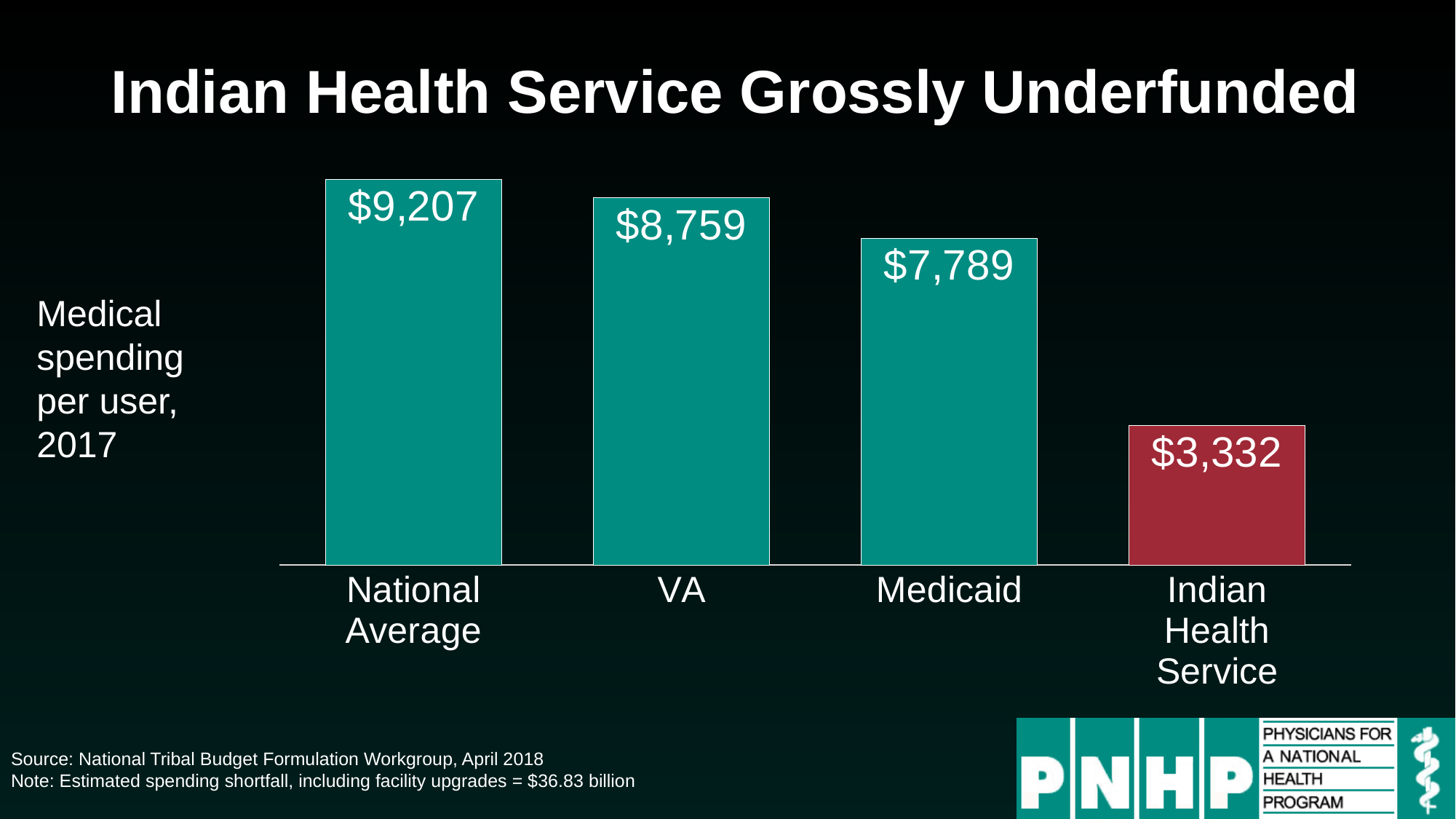
Which bar is coloured differently (red) from the others? Indian Health Service What is the difference between VA and Medicaid spending per user? $970 Which category has the highest medical spending per user? National Average What is the medical spending per user for the VA? $8,759 What kind of chart is shown on the slide? Bar chart What is the medical spending per user for the Indian Health Service? $3,332 What is the medical spending per user for Medicaid? $7,789 How many categories are shown in the chart? 4 What is the difference between the National Average and the Indian Health Service spending per user? $5,875 Which has higher medical spending per user, VA or Medicaid? VA Which category has the lowest medical spending per user? Indian Health Service What is the National Average medical spending per user? $9,207